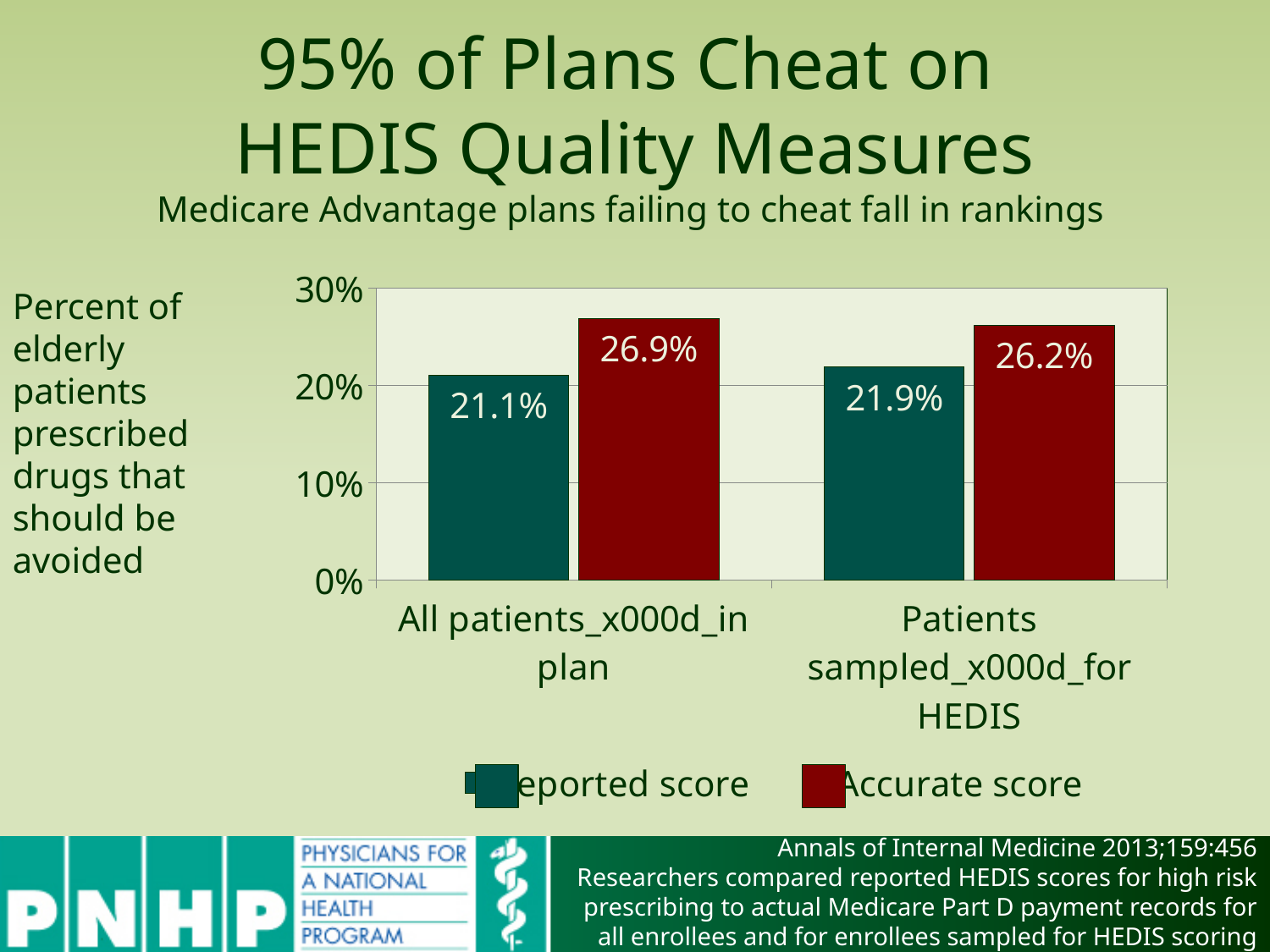
What is the Reported score for All patients in plan? 21.1% Which bar has the highest value on the chart? Accurate score for All patients in plan (26.9%) What is the Reported score for Patients sampled for HEDIS? 21.9% Which bar has the lowest value on the chart? Reported score for All patients in plan (21.1%) How many categories are shown on the x axis? 2 What is the Accurate score for All patients in plan? 26.9% How many series does the legend list? 2 What kind of chart is shown on the slide? Bar chart What is the Accurate score for Patients sampled for HEDIS? 26.2% What is the difference between the Accurate score and the Reported score for All patients in plan? 5.8 percentage points Which category has the larger Reported score, All patients in plan or Patients sampled for HEDIS? Patients sampled for HEDIS What is the difference between the Accurate score and the Reported score for Patients sampled for HEDIS? 4.3 percentage points